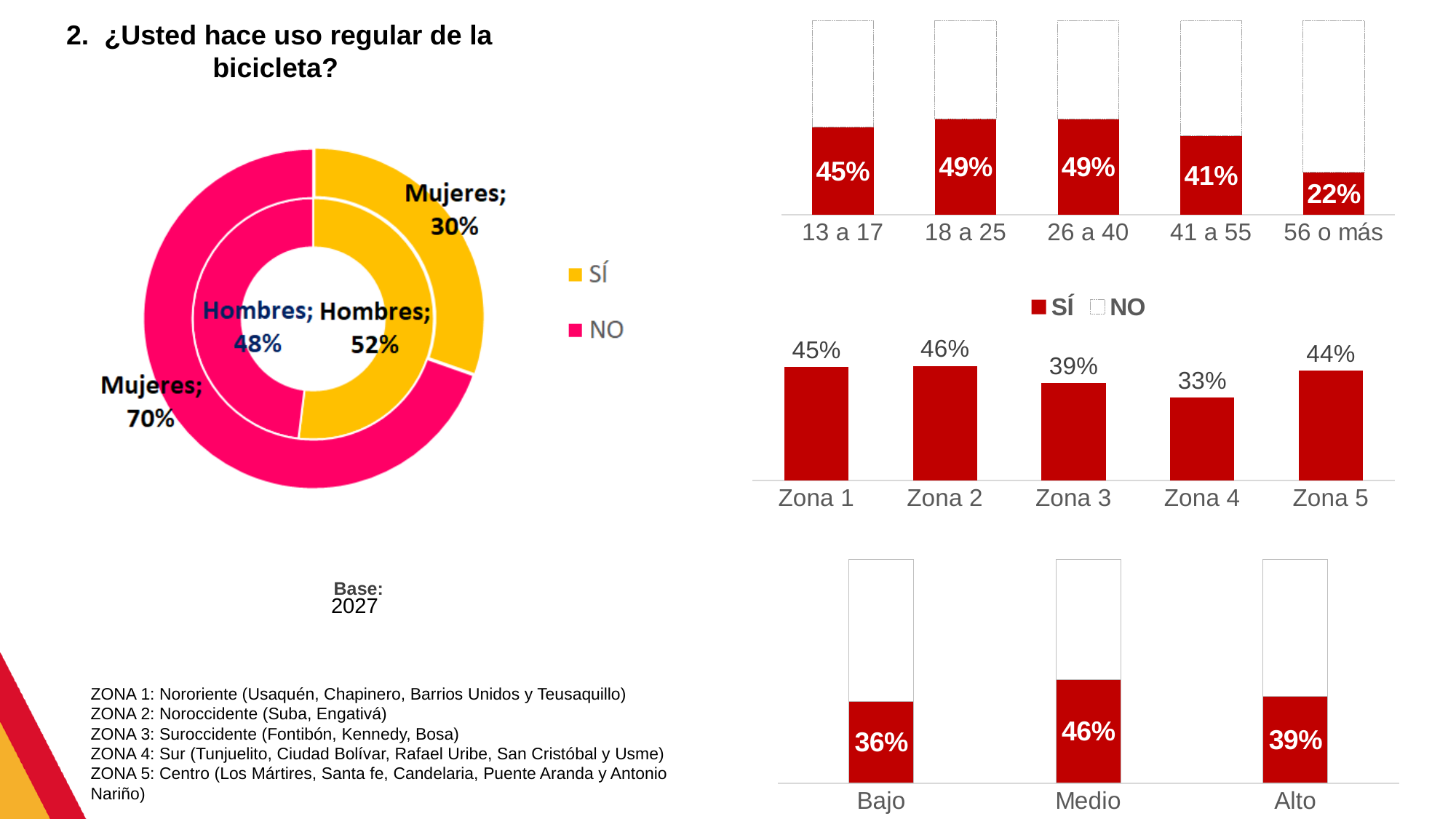
In the age-group chart at the top right, what is the difference between the SÍ values for 13 a 17 and 41 a 55? 4 percentage points In the zone chart in the middle right, which zone has the lowest value? Zona 4 In the age-group chart at the top right, how many age groups are shown? 5 In the zone chart in the middle right, what is the value for Zona 3? 39% In the socioeconomic level chart at the bottom right, which level has the highest SÍ value? Medio In the zone chart in the middle right, which is larger, Zona 1 or Zona 4? Zona 1 In the doughnut chart on the left, how many entries does the legend list? 2 In the zone chart in the middle right, what is the difference between Zona 2 and Zona 4? 13 percentage points In the socioeconomic level chart at the bottom right, what is the SÍ value for Alto? 39% In the doughnut chart on the left, what percentage of Mujeres answered NO? 70% In the age-group chart at the top right, what is the SÍ value for the 56 o más group? 22% In the age-group chart at the top right, which age group has the lowest SÍ value? 56 o más